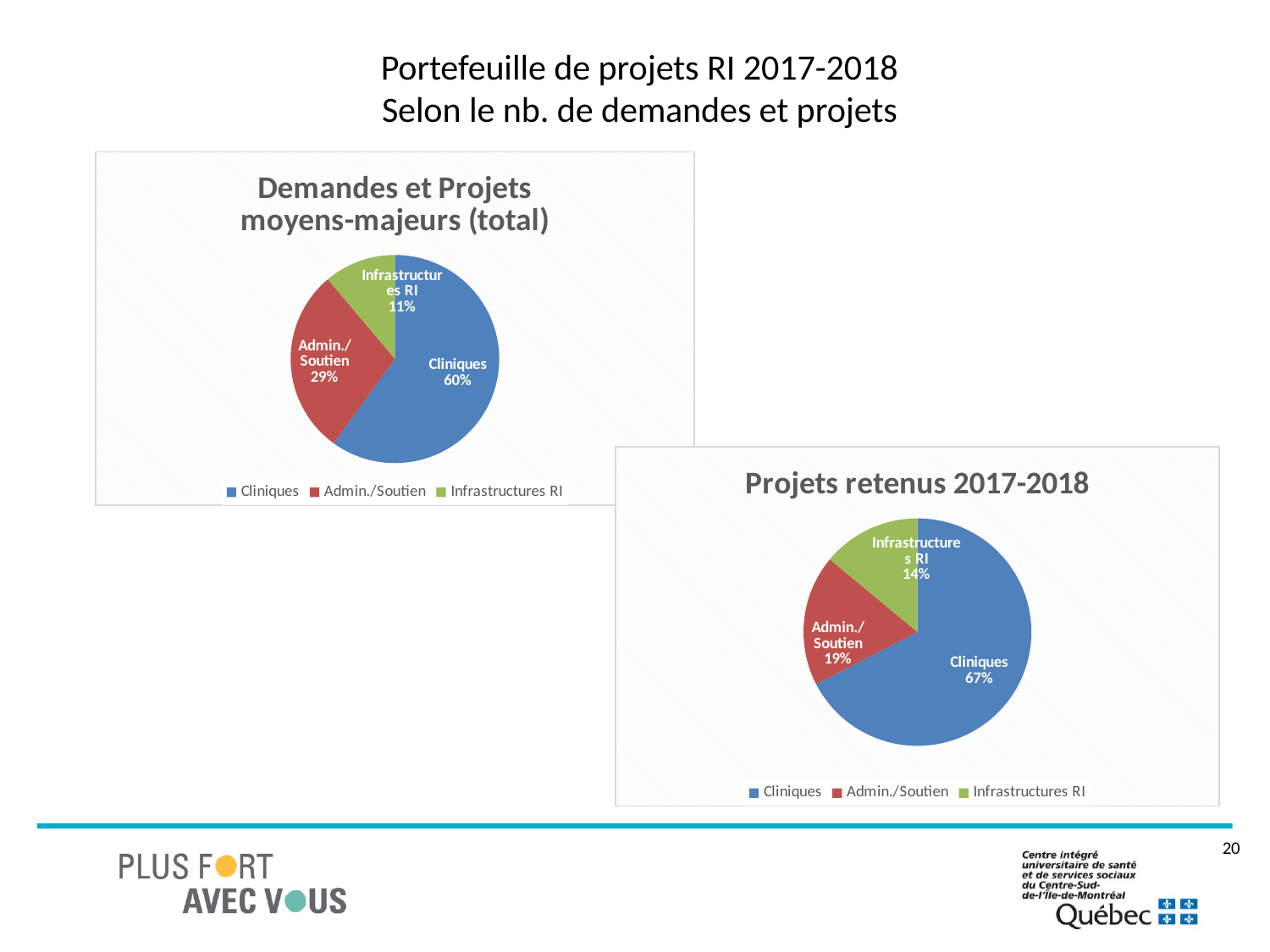
In the 'Demandes et Projets moyens-majeurs (total)' chart, which category has the largest slice? Cliniques In the 'Demandes et Projets moyens-majeurs (total)' chart, what share does Cliniques have? 60% What kind of chart is 'Projets retenus 2017-2018'? Pie chart In the 'Projets retenus 2017-2018' chart, what share does Infrastructures RI have? 14% In the 'Projets retenus 2017-2018' chart, what is the difference in percentage points between Cliniques and Admin./Soutien? 48 How many categories does the 'Projets retenus 2017-2018' chart show? 3 In the 'Projets retenus 2017-2018' chart, which category has the smallest slice? Infrastructures RI In the 'Demandes et Projets moyens-majeurs (total)' chart, what share does Admin./Soutien have? 29% In the 'Demandes et Projets moyens-majeurs (total)' chart, which is larger: Admin./Soutien or Infrastructures RI? Admin./Soutien